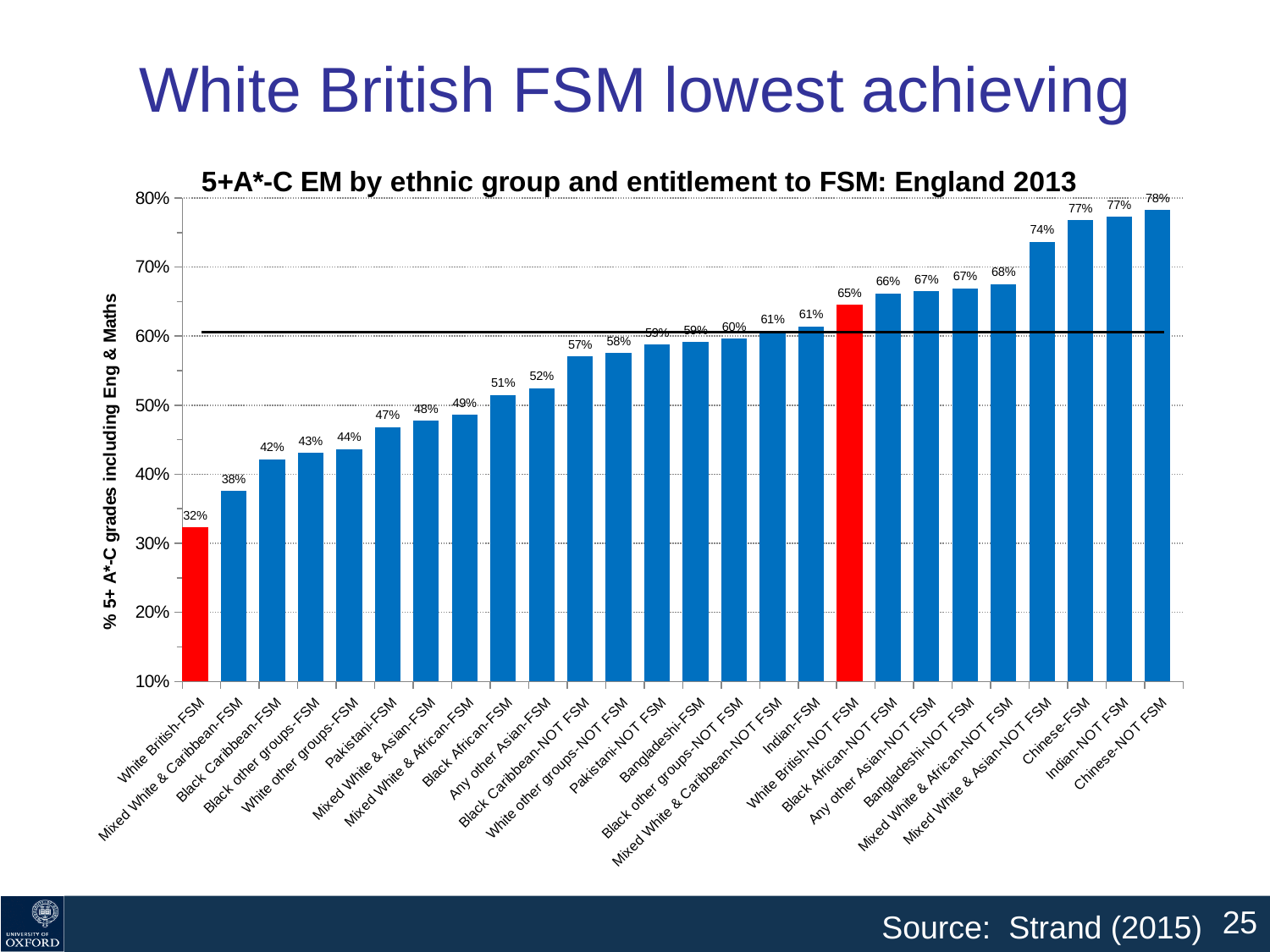
What kind of chart is shown on the slide? bar chart What is the value for White British-FSM? 32% Which two bars are coloured red? White British-FSM and White British-NOT FSM Which category has the lowest value? White British-FSM Which category has the highest value? Chinese-NOT FSM Which is larger, the value for Indian-FSM or the value for Black African-FSM? Indian-FSM Do the values rise or fall from left to right along the x axis? rise Is the value for Mixed White & Asian-NOT FSM greater or less than 70%? greater What is the value for Chinese-FSM? 77% What is the difference between the values for White British-NOT FSM and White British-FSM? 33% How many bars are plotted in the chart? 26 What is the value for White British-NOT FSM? 65%